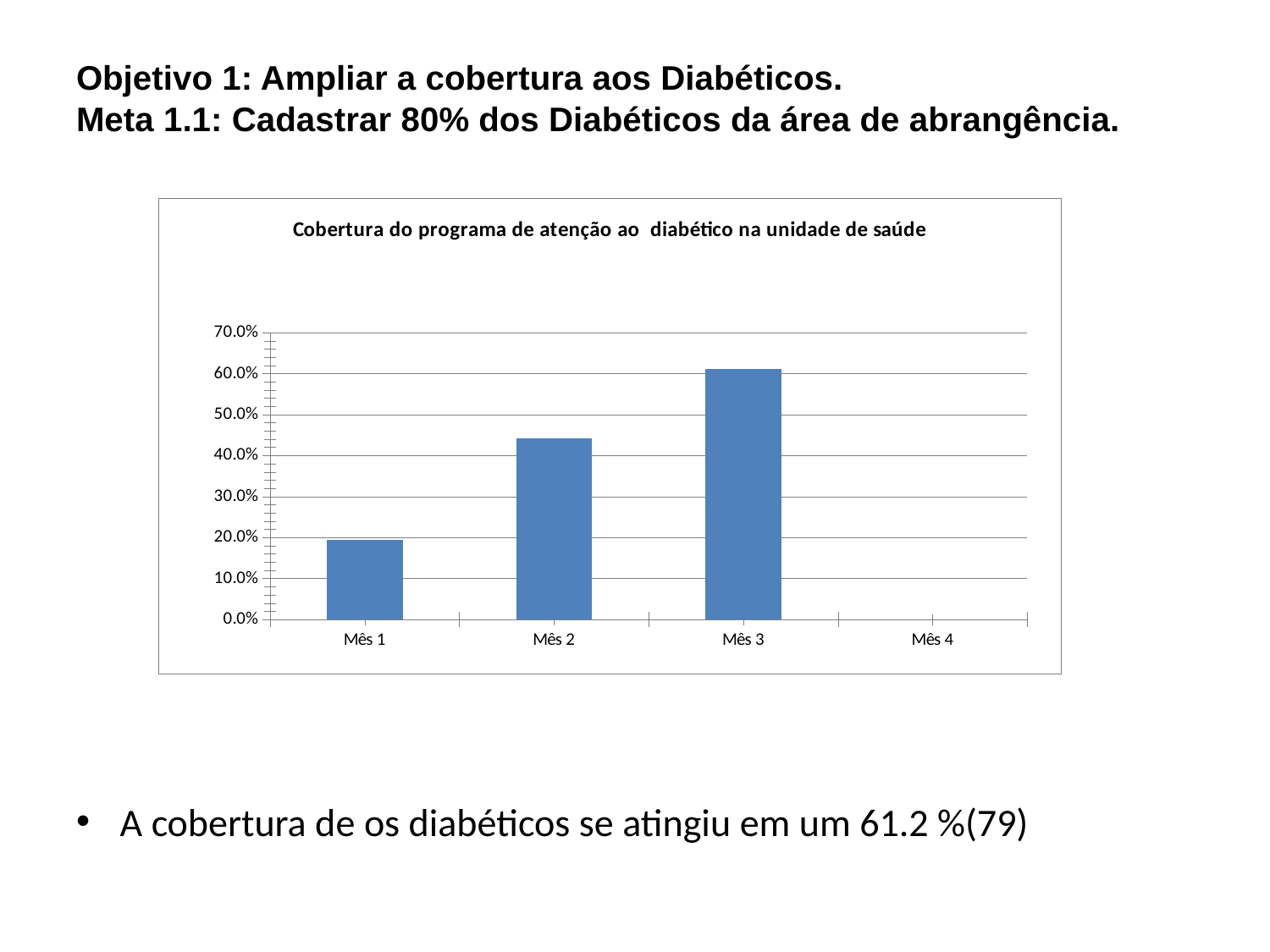
Is the value for Mês 3 greater or less than 50.0%? greater What is the highest value shown on the y axis of the chart? 70.0% What is the title of the chart? Cobertura do programa de atenção ao diabético na unidade de saúde How many categories are shown on the x axis of the chart? 4 Is the value for Mês 1 greater or less than 30.0%? less What kind of chart is shown on the slide? bar chart Is the value for Mês 2 greater or less than 40.0%? greater Which is larger, the value for Mês 2 or the value for Mês 3? Mês 3 Which month with a visible bar has the lowest value in the chart? Mês 1 Do the values rise or fall from Mês 1 to Mês 3? rise Which month has the highest bar in the chart? Mês 3